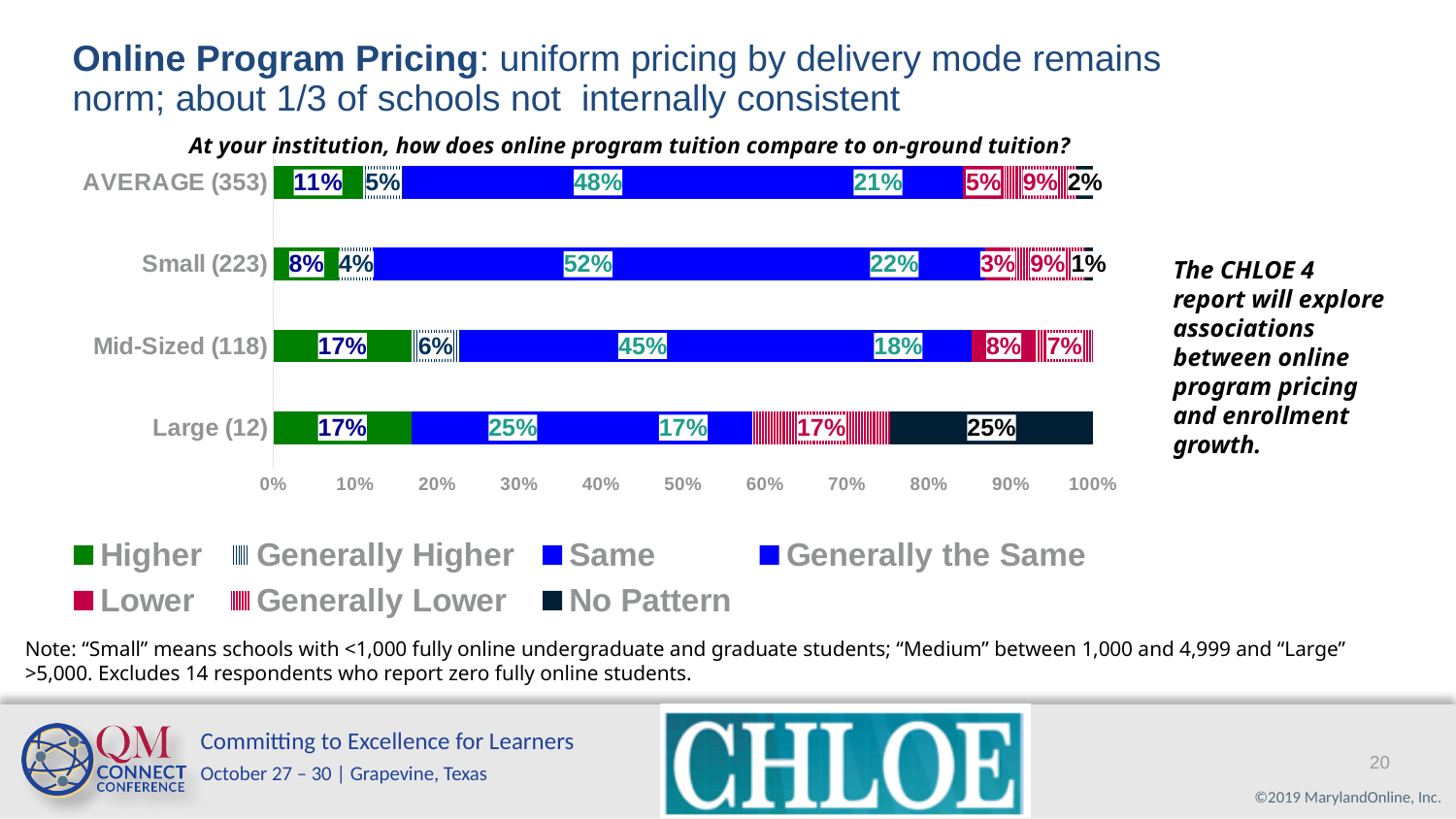
What is the 'Higher' value for Mid-Sized (118) institutions? 17% Which institution category has the lowest 'Higher' percentage? Small (223) What kind of chart is shown on the slide? Stacked bar chart How many series does the chart legend list? 7 What percentage of Small (223) institutions report online tuition is the 'Same' as on-ground tuition? 52% Which institution category has the highest 'Same' percentage? Small (223) What is the difference between the 'Same' value for Small (223) and the 'Same' value for Mid-Sized (118)? 7 percentage points How many institution categories are plotted in the chart? 4 What is the 'Lower' value for Mid-Sized (118) institutions? 8% What is the 'Generally Lower' value for AVERAGE (353)? 9% What is the 'No Pattern' value for Large (12) institutions? 25% Which has a larger 'Generally the Same' value, Small (223) or Mid-Sized (118)? Small (223)